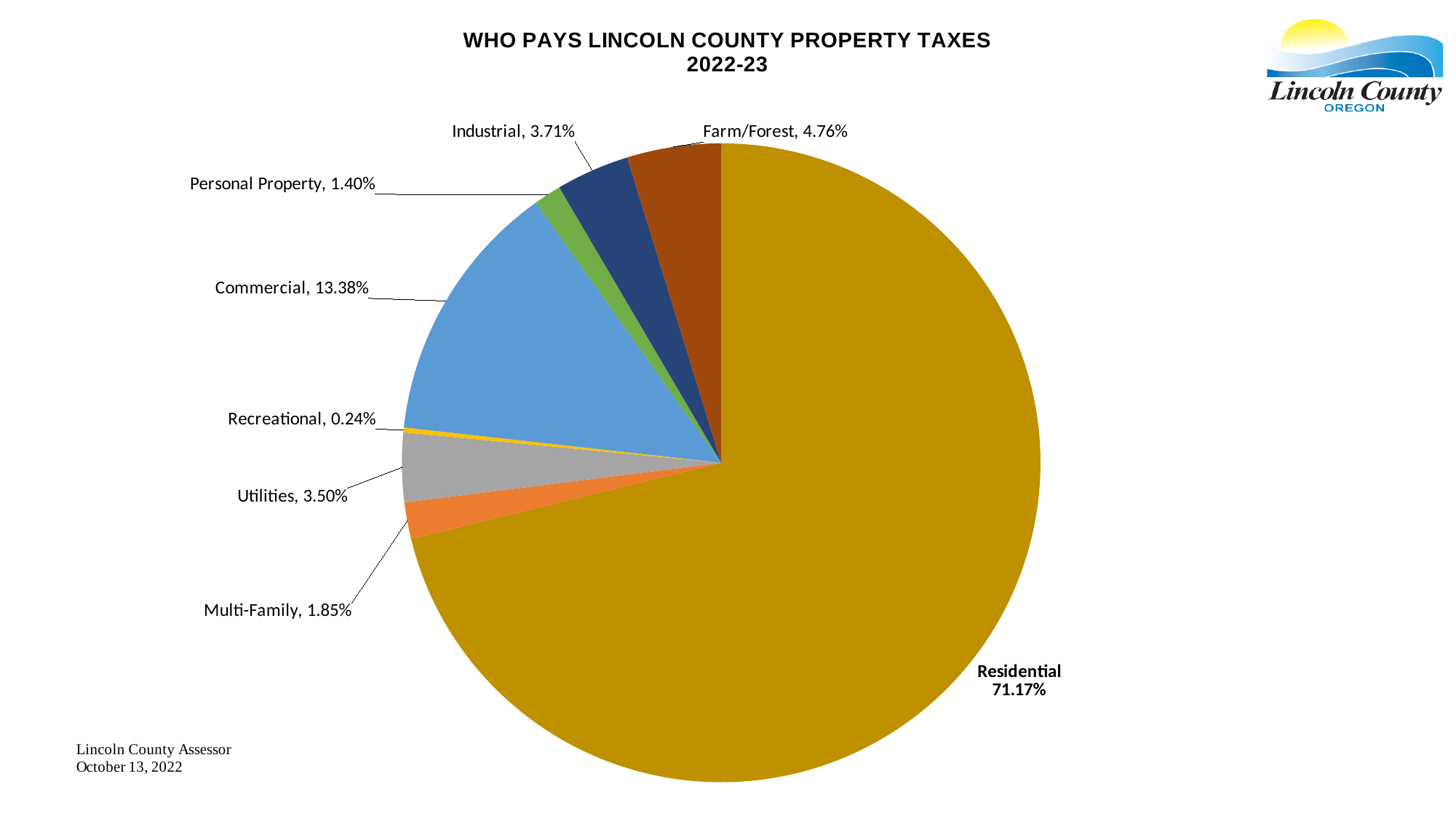
How many categories are shown in the pie chart? 8 What percentage of property taxes does the Commercial category pay? 13.38% Which category pays the smallest share of property taxes? Recreational What is the value shown for Farm/Forest? 4.76% Which is larger, the Industrial share or the Utilities share? Industrial What kind of chart is shown on the slide? Pie chart What is the difference between the Commercial and Farm/Forest shares? 8.62% Which category pays the largest share of property taxes? Residential What is the title of the chart? WHO PAYS LINCOLN COUNTY PROPERTY TAXES 2022-23 What is the combined share of Multi-Family and Personal Property? 3.25% What percentage is shown for Utilities? 3.50% What share of Lincoln County property taxes is paid by Residential property? 71.17%